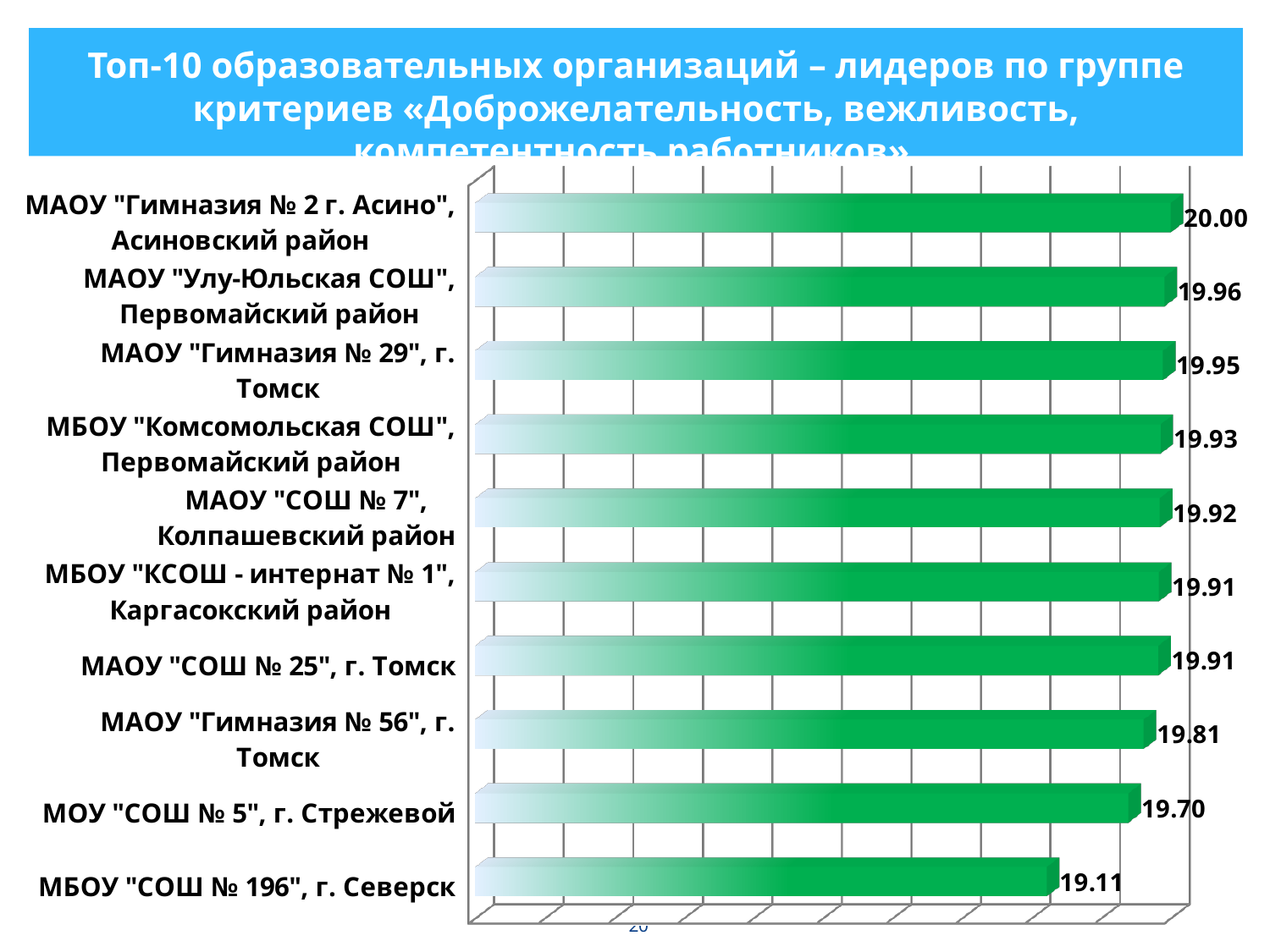
Do the values increase or decrease going from the top bar to the bottom bar? Decrease What value is shown for МАОУ "Гимназия № 29", г. Томск? 19.95 Which has the larger value: МАОУ "СОШ № 25", г. Томск or МАОУ "Гимназия № 56", г. Томск? МАОУ "СОШ № 25", г. Томск Which organisation has the lowest value on the chart? МБОУ "СОШ № 196", г. Северск What is the difference between the values for МАОУ "Гимназия № 56", г. Томск and МОУ "СОШ № 5", г. Стрежевой? 0.11 What value is shown for МОУ "СОШ № 5", г. Стрежевой? 19.70 What value is shown for МБОУ "СОШ № 196", г. Северск? 19.11 What is the difference between the values for МАОУ "Гимназия № 2 г. Асино" and МБОУ "СОШ № 196", г. Северск? 0.89 What value is shown for МАОУ "Гимназия № 2 г. Асино", Асиновский район? 20.00 Which organisation has the highest value on the chart? МАОУ "Гимназия № 2 г. Асино", Асиновский район How many organisations are shown on the chart? 10 What kind of chart is shown on the slide? Bar chart